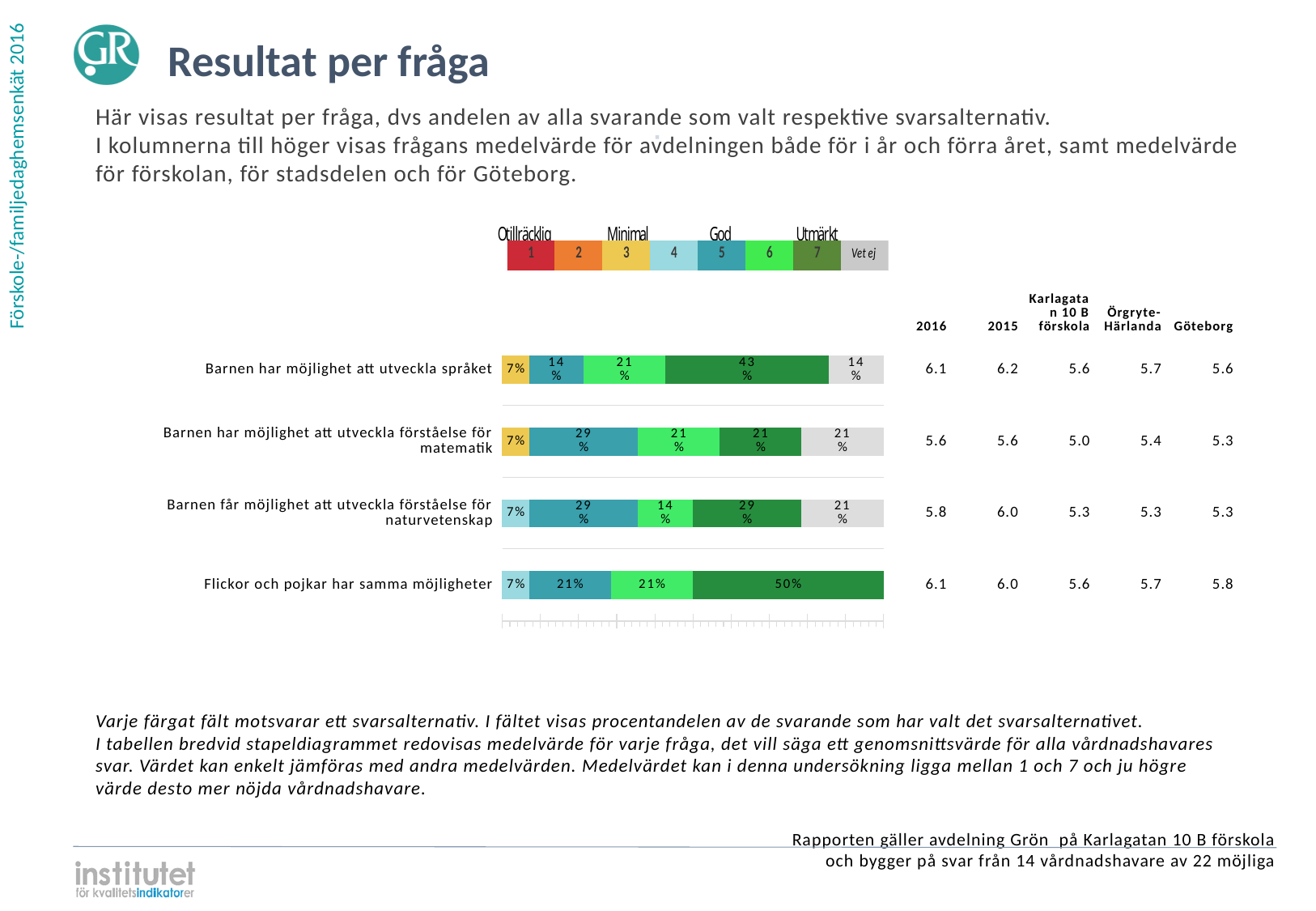
Which question has the lowest 2016 mean value in the table next to the chart? Barnen har möjlighet att utveckla förståelse för matematik How many questions (categories) are plotted as bars in the chart? 4 What percentage answered "Vet ej" for "Barnen har möjlighet att utveckla förståelse för matematik"? 21% What is the Göteborg mean value shown for "Flickor och pojkar har samma möjligheter"? 5.8 What kind of chart is shown on the slide? Stacked bar chart What percentage of respondents chose the highest rating (7, dark green) for "Flickor och pojkar har samma möjligheter"? 50% What is the difference between the dark green (7) share for "Flickor och pojkar har samma möjligheter" and for "Barnen har möjlighet att utveckla språket"? 7 percentage points What percentage of respondents chose the highest rating (7, dark green) for "Barnen har möjlighet att utveckla språket"? 43% What are the four rating labels shown above the colour legend of the chart? Otillräcklig, Minimal, God, Utmärkt Which question has the largest share of respondents choosing the highest rating (7, dark green)? Flickor och pojkar har samma möjligheter Which is larger: the teal (5) share for "Barnen får möjlighet att utveckla förståelse för naturvetenskap" or the teal (5) share for "Barnen har möjlighet att utveckla språket"? Barnen får möjlighet att utveckla förståelse för naturvetenskap What is the 2016 mean value shown for "Barnen har möjlighet att utveckla förståelse för matematik"? 5.6